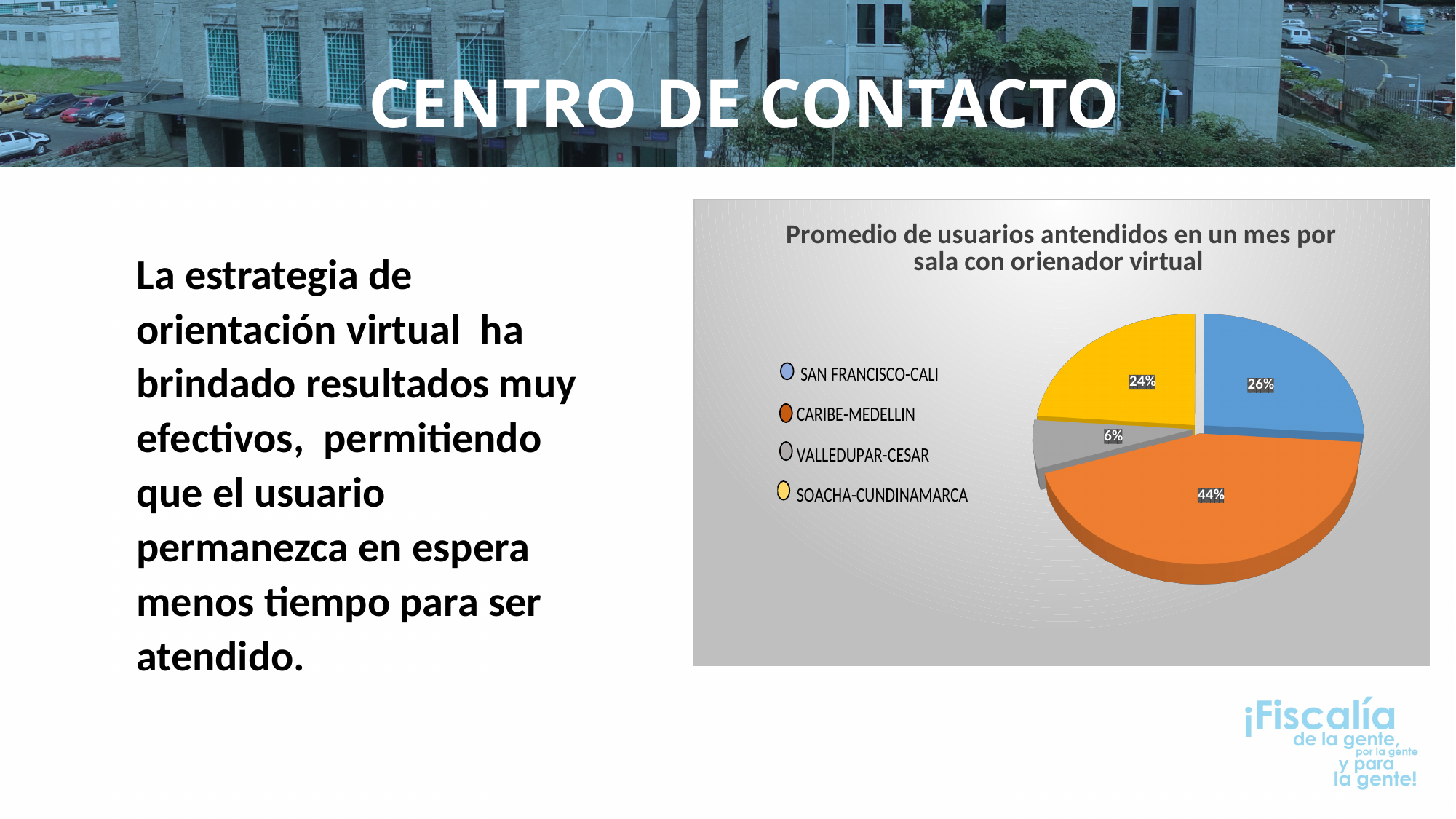
What kind of chart is shown on the slide? Pie chart What is the title of the chart? Promedio de usuarios antendidos en un mes por sala con orienador virtual What share of the pie does SOACHA-CUNDINAMARCA have? 24% Which category has the largest slice of the pie? CARIBE-MEDELLIN Which is larger, the share for SAN FRANCISCO-CALI or the share for SOACHA-CUNDINAMARCA? SAN FRANCISCO-CALI What is the difference in percentage points between CARIBE-MEDELLIN and SAN FRANCISCO-CALI? 18 Which category has the smallest slice of the pie? VALLEDUPAR-CESAR How many categories are shown in the pie chart? 4 What share of the pie does CARIBE-MEDELLIN have? 44% What share of the pie does SAN FRANCISCO-CALI have? 26% What colour is the slice for SOACHA-CUNDINAMARCA? Yellow